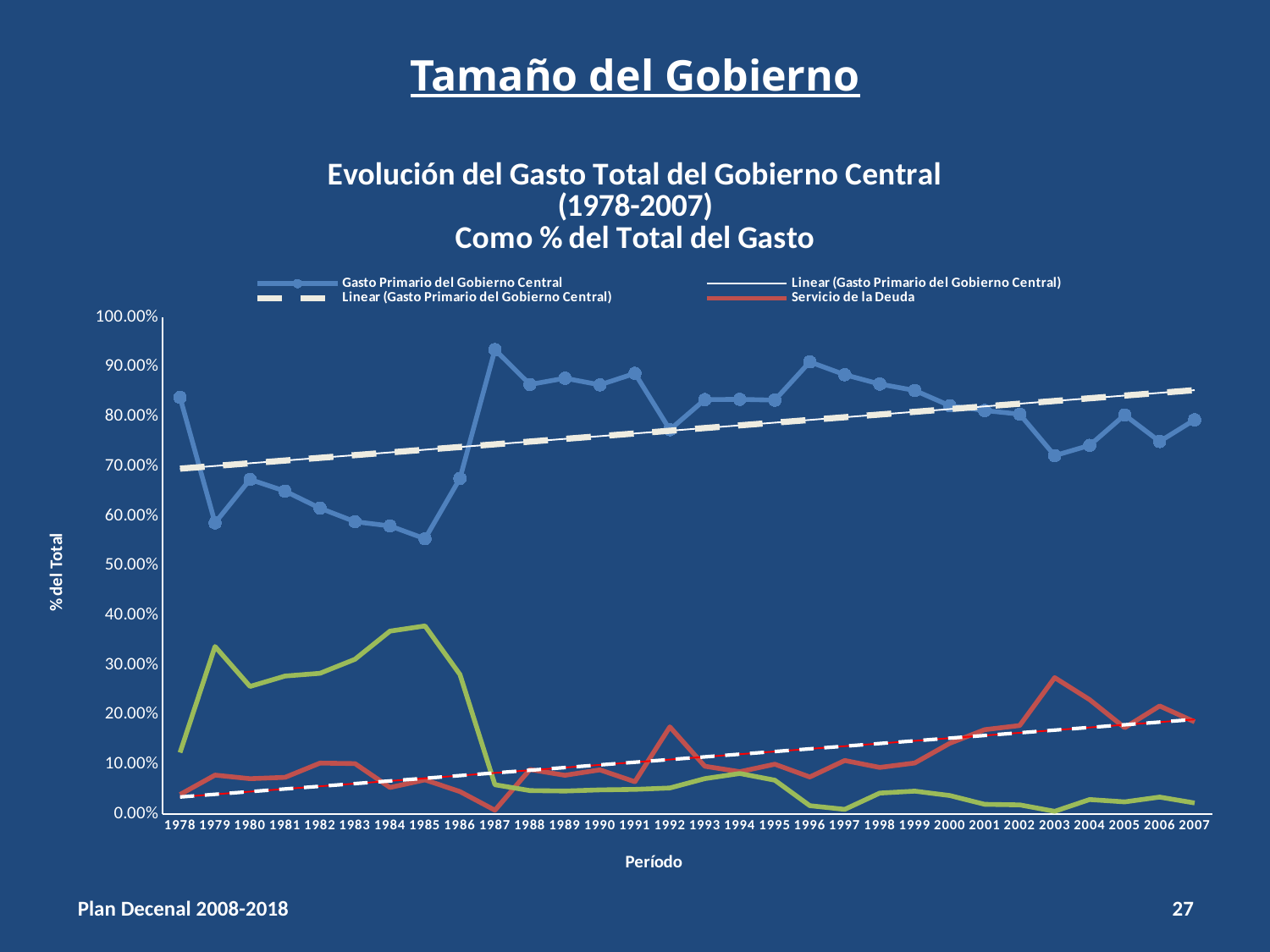
Does the dashed linear trend line for Gasto Primario del Gobierno Central rise or fall from 1978 to 2007? rise Is the value for Servicio de la Deuda in 2003 greater or less than 20.00%? greater In which year does Gasto Primario del Gobierno Central reach its highest value? 1987 What is the label of the x axis of the chart? Período Is the value for Gasto Primario del Gobierno Central in 1979 greater or less than 60.00%? less How many years are plotted along the x axis of the chart? 30 Is the value for Gasto Primario del Gobierno Central in 1978 greater or less than 80.00%? greater What kind of chart is shown on the slide? line chart How many series does the chart legend list? 4 Which is larger, Servicio de la Deuda in 2003 or Servicio de la Deuda in 1992? 2003 In which year does Gasto Primario del Gobierno Central reach its lowest value? 1985 In which year does Servicio de la Deuda reach its highest value? 2003